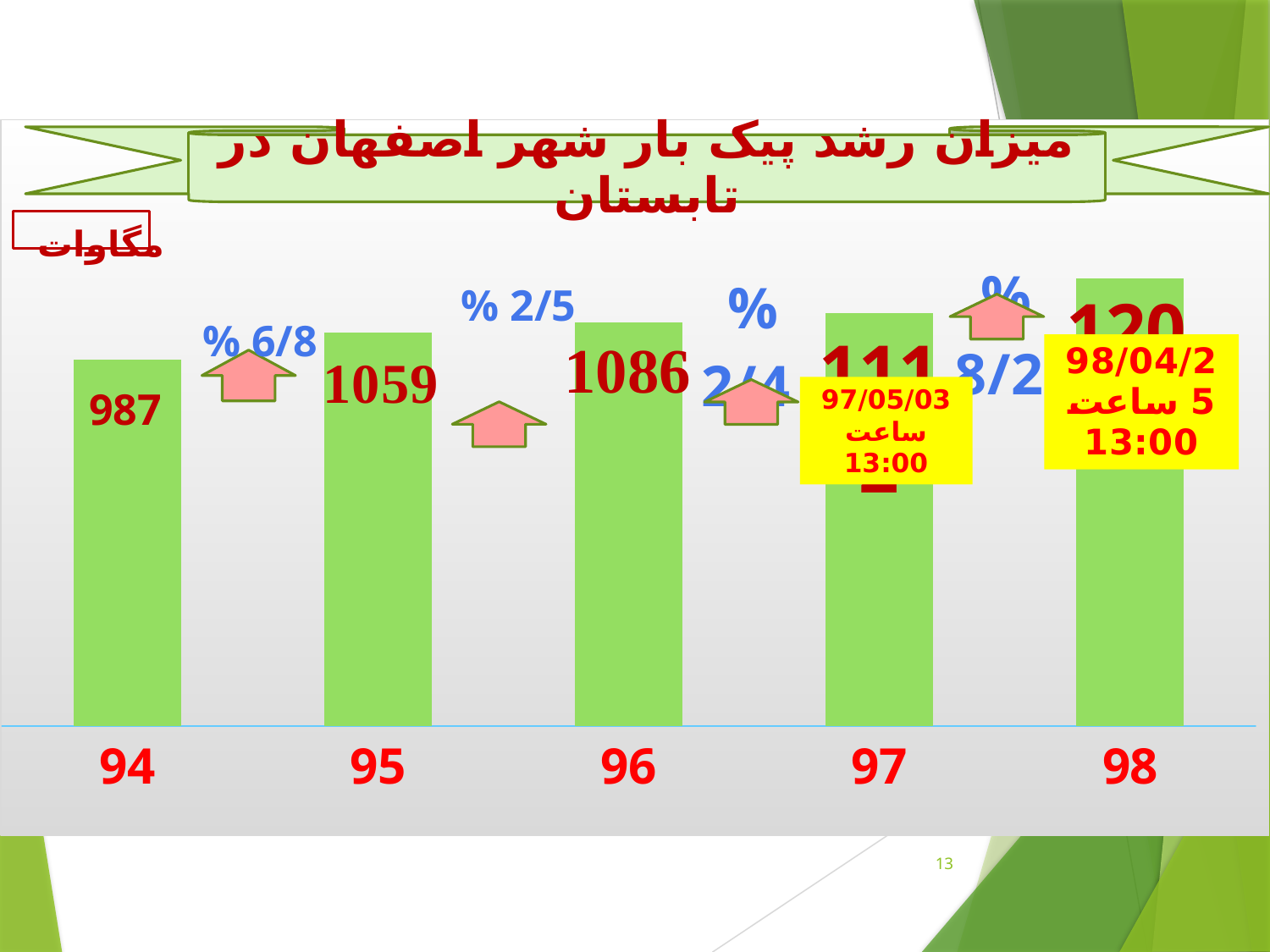
What type of chart is shown on the slide? bar chart What is the value shown for year 94? 987 Do the bar values rise or fall from year 94 to year 98? rise How many bars (years) are plotted in the chart? 5 What is the value shown for year 95? 1059 What growth percentage is shown between year 94 and year 95? % 6/8 What is the difference between the values for year 95 and year 94? 72 What is the value shown for year 96? 1086 What is the difference between the values for year 96 and year 95? 27 Which year has the highest bar in the chart? 98 Which is larger, the value for year 96 or the value for year 95? 96 Which year has the lowest bar in the chart? 94